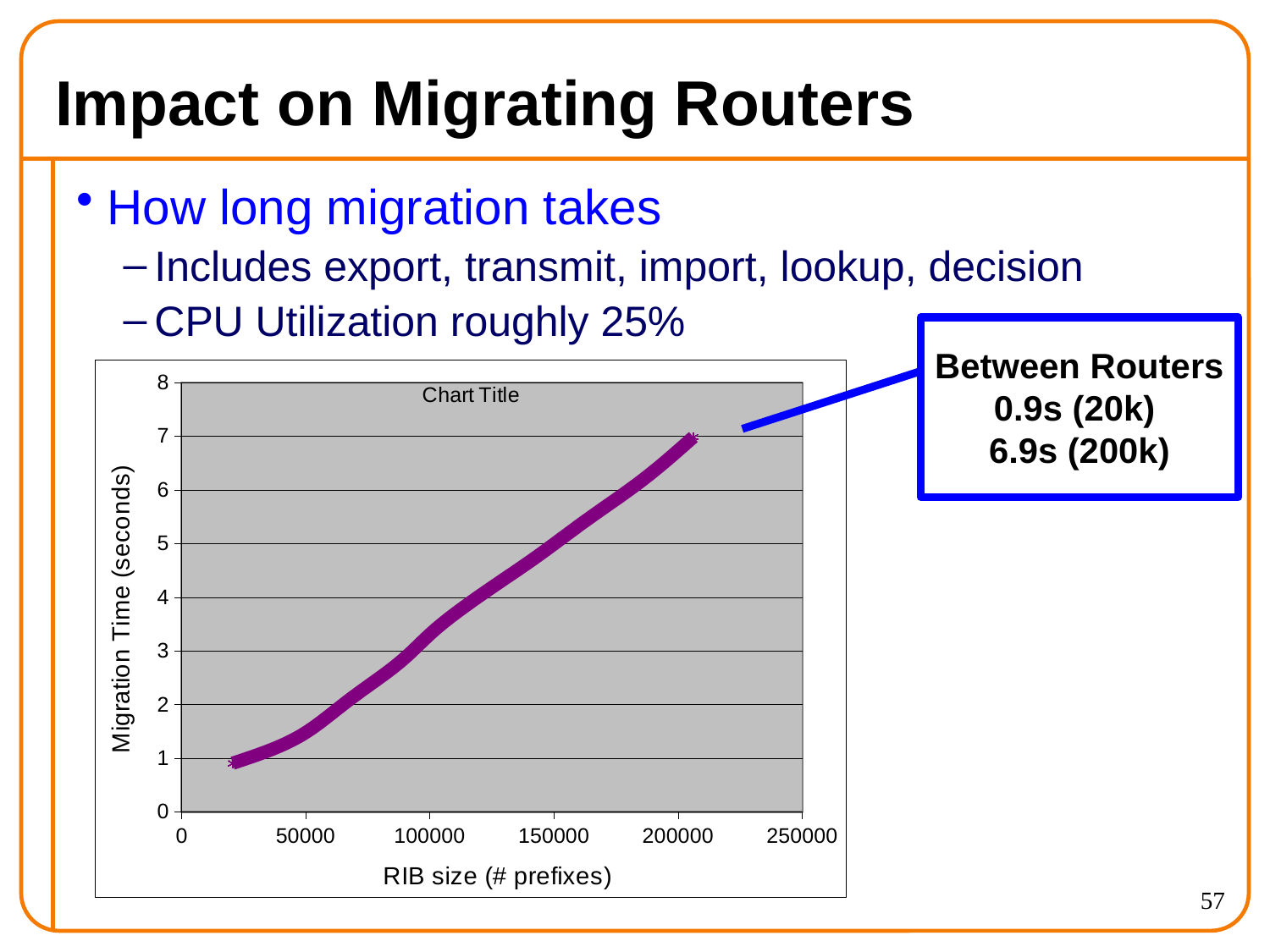
What is the migration time between routers for a RIB size of 200k prefixes? 6.9s What kind of chart is shown on the slide? line chart What is the label of the y-axis of the chart? Migration Time (seconds) Is the migration time at a RIB size of 150000 prefixes greater or less than 4 seconds? greater Which RIB size has the larger migration time, 20k or 200k prefixes? 200k Does migration time rise or fall as RIB size increases? rise Is the migration time at a RIB size of 50000 prefixes greater or less than 2 seconds? less What is the migration time between routers for a RIB size of 20k prefixes? 0.9s What is the label of the x-axis of the chart? RIB size (# prefixes) Is the migration time at a RIB size of 100000 prefixes greater or less than 5 seconds? less What is the difference in migration time between a 200k-prefix RIB and a 20k-prefix RIB? 6.0s